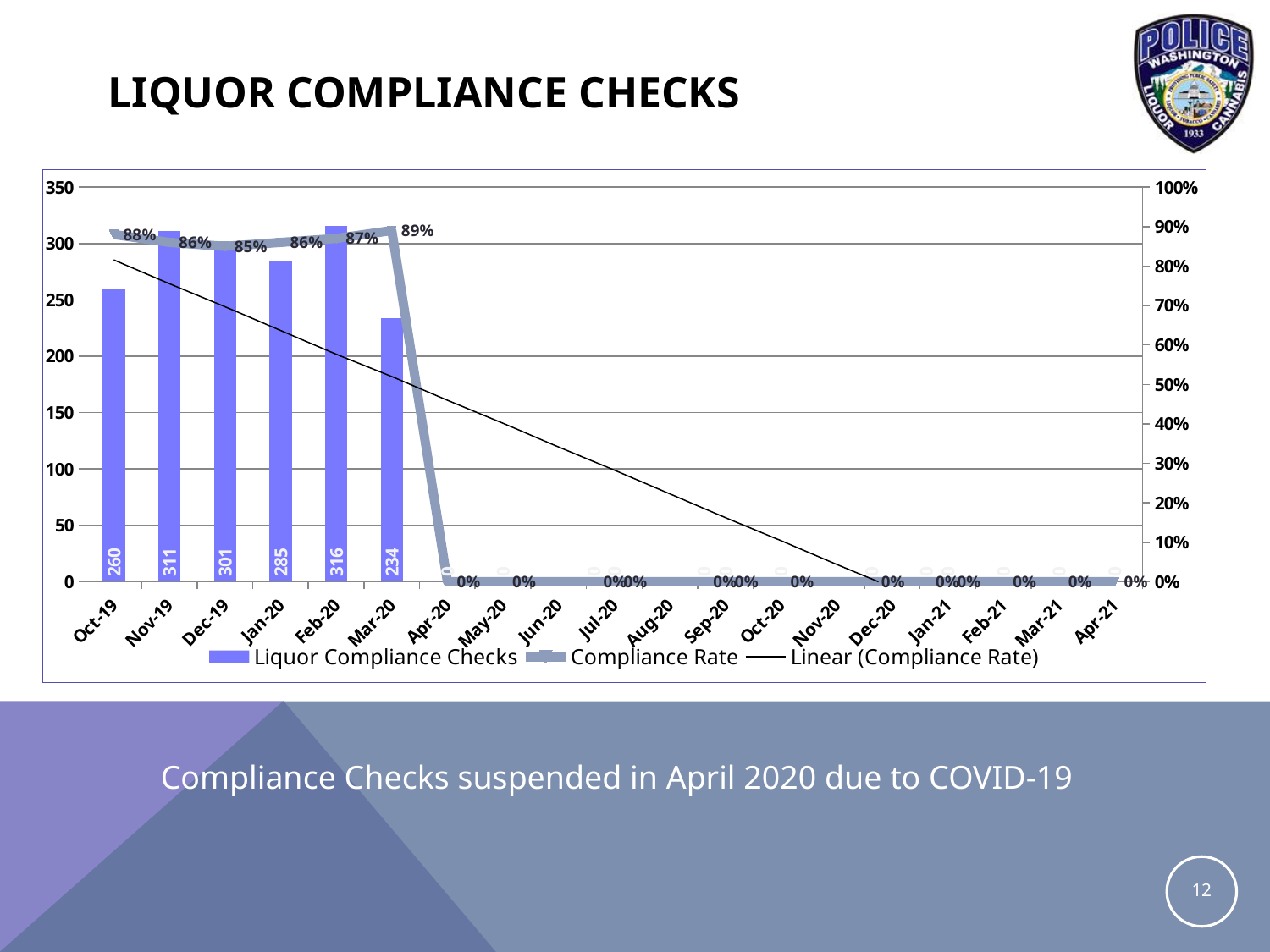
What was the Compliance Rate in Dec-19? 85% Among the months with a non-zero bar, which month had the fewest Liquor Compliance Checks? Mar-20 What is the title of the chart on the slide? LIQUOR COMPLIANCE CHECKS What is the difference in Liquor Compliance Checks between Feb-20 and Mar-20? 82 Which month had more Liquor Compliance Checks, Oct-19 or Jan-20? Jan-20 How many months are shown on the x axis? 19 How many series does the legend list? 3 What is the Compliance Rate shown for Apr-20 through Apr-21? 0% What was the Compliance Rate in Mar-20? 89% Is the number of Liquor Compliance Checks in Dec-19 greater or less than 250? greater How many Liquor Compliance Checks were conducted in Nov-19? 311 Which month had the highest number of Liquor Compliance Checks? Feb-20